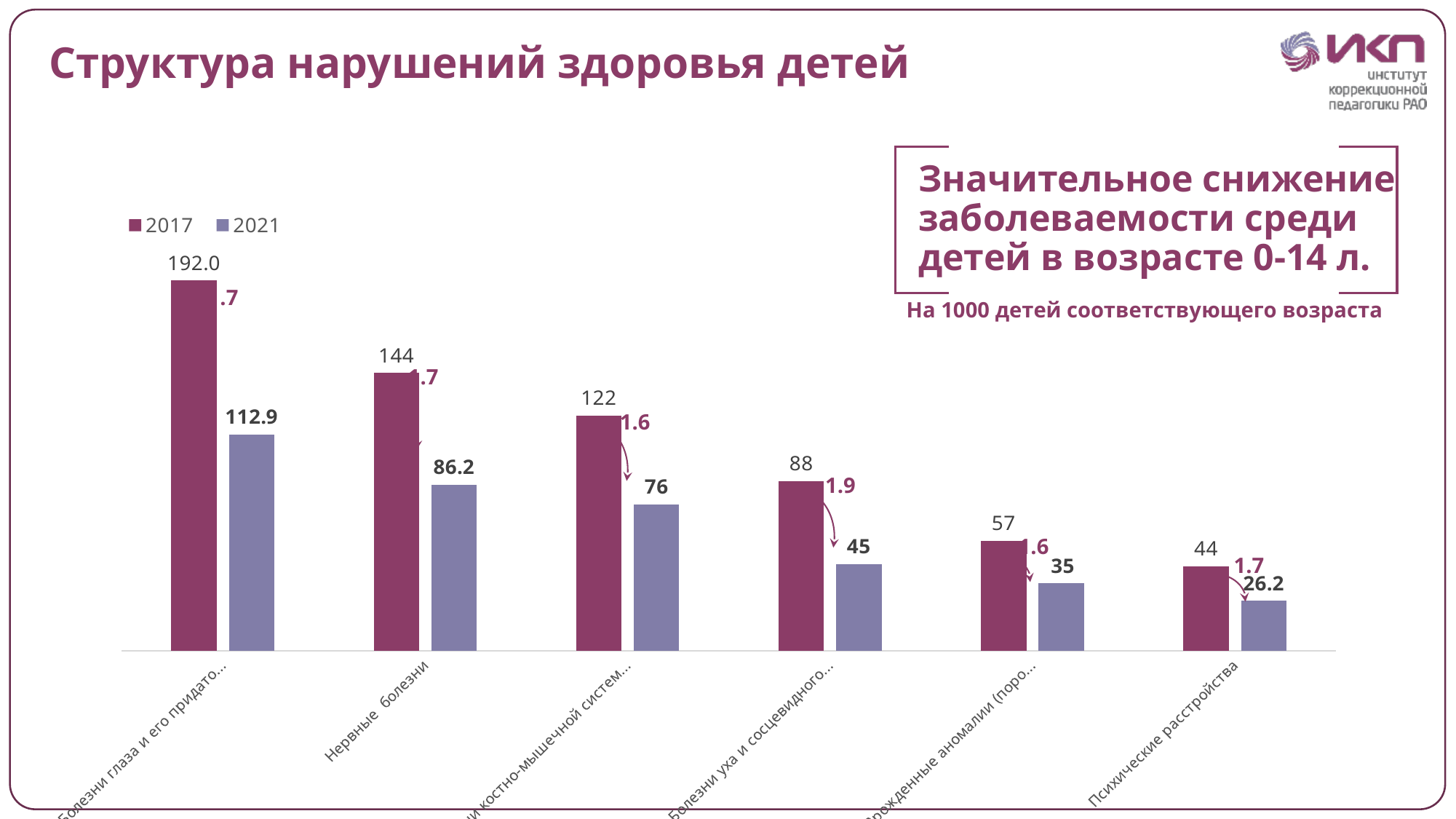
Do the 2017 values rise or fall from left to right along the x axis? Fall What is the 2021 value for Нервные болезни? 86.2 What is the highest 2021 value shown on the chart? 112.9 By how much did the value for Нервные болезни fall from 2017 to 2021? 57.8 How many series does the legend list? 2 What is the 2017 value for Нервные болезни? 144 How many categories are shown on the x axis? 6 What is the difference between the 2017 and 2021 values for Психические расстройства? 17.8 What is the 2017 value for Психические расстройства? 44 What is the 2021 value for Психические расстройства? 26.2 Which category has the lowest 2017 value? Психические расстройства What kind of chart is shown on the slide? Bar chart